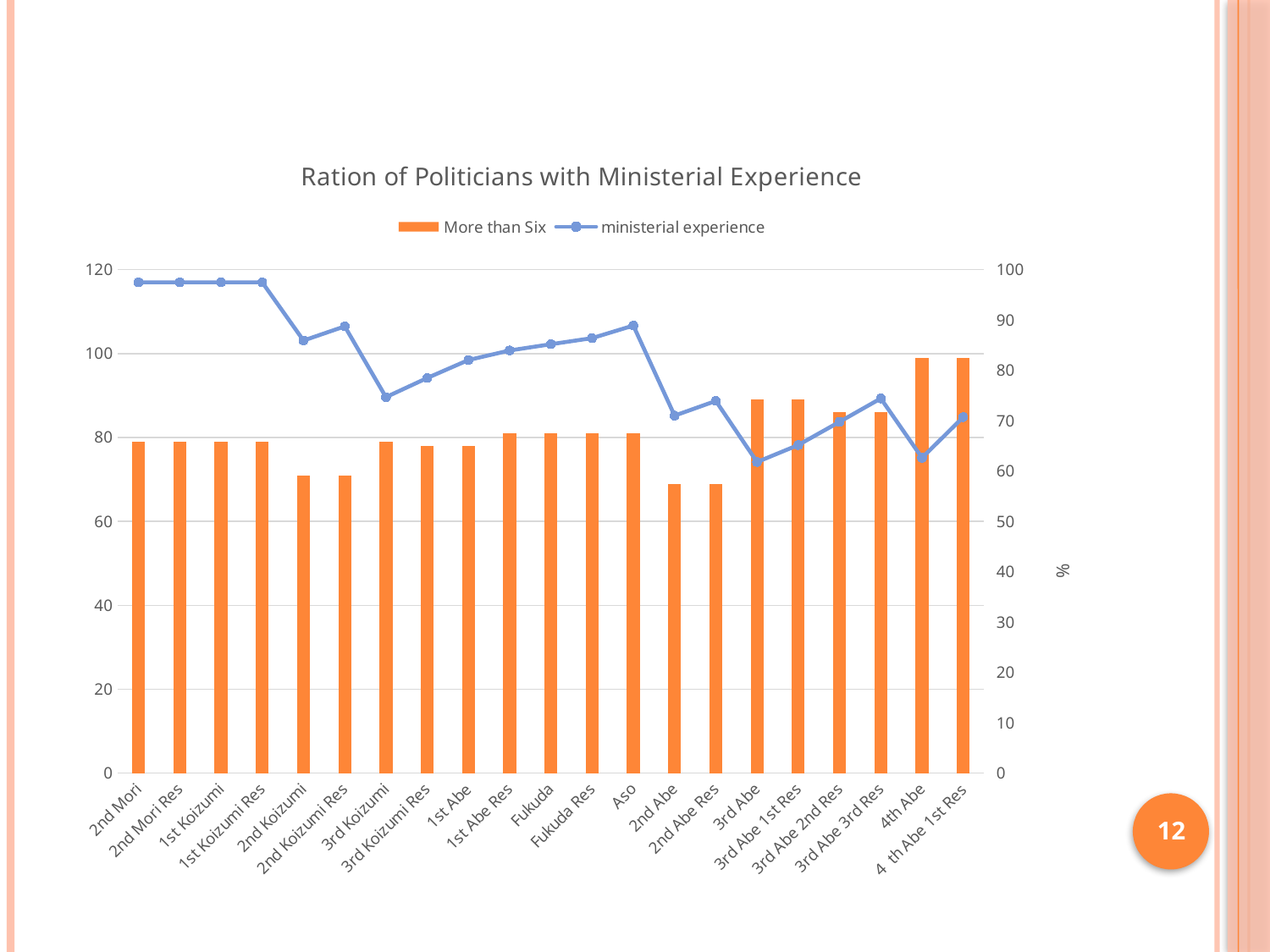
Which series is drawn as a line with markers? ministerial experience Is the ministerial experience value for 3rd Abe greater or less than 70 on the right axis? less Which has the larger More than Six bar, 4th Abe or 2nd Abe? 4th Abe Is the More than Six bar for 2nd Abe greater or less than 80? less How many categories are shown along the x axis? 21 What is the title of the chart? Ration of Politicians with Ministerial Experience Does the ministerial experience line generally rise or fall from left to right across the chart? fall What kind of chart is shown on the slide? A combined bar and line chart Is the More than Six bar for 4th Abe greater or less than 80? greater How many series does the legend list? 2 Which has the higher ministerial experience value, 1st Koizumi or 3rd Abe? 1st Koizumi